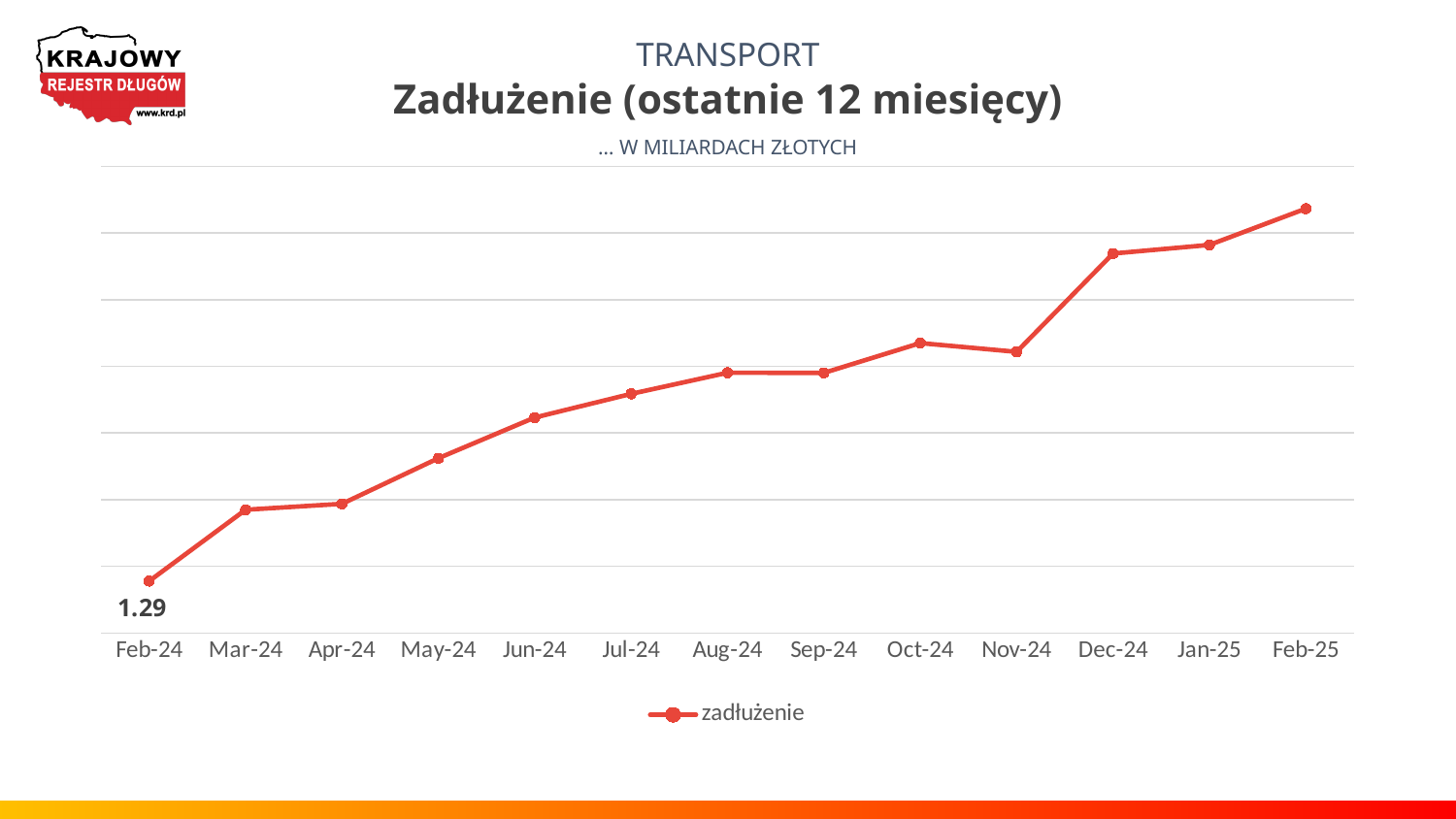
Which month has the lowest value? Feb-24 Which month has the highest value? Feb-25 How many series does the legend list? 1 What is the name of the series shown in the legend? zadłużenie How many data points are plotted on the chart? 13 What is the value for Feb-24? 1.29 Do the values rise or fall from Feb-24 to Feb-25? Rise Which is larger, the value for Oct-24 or the value for Jan-25? Jan-25 What is the title of the chart? Zadłużenie (ostatnie 12 miesięcy) What kind of chart is shown on the slide? Line chart Which is larger, the value for May-24 or the value for Jun-24? Jun-24 Which is larger, the value for Nov-24 or the value for Dec-24? Dec-24